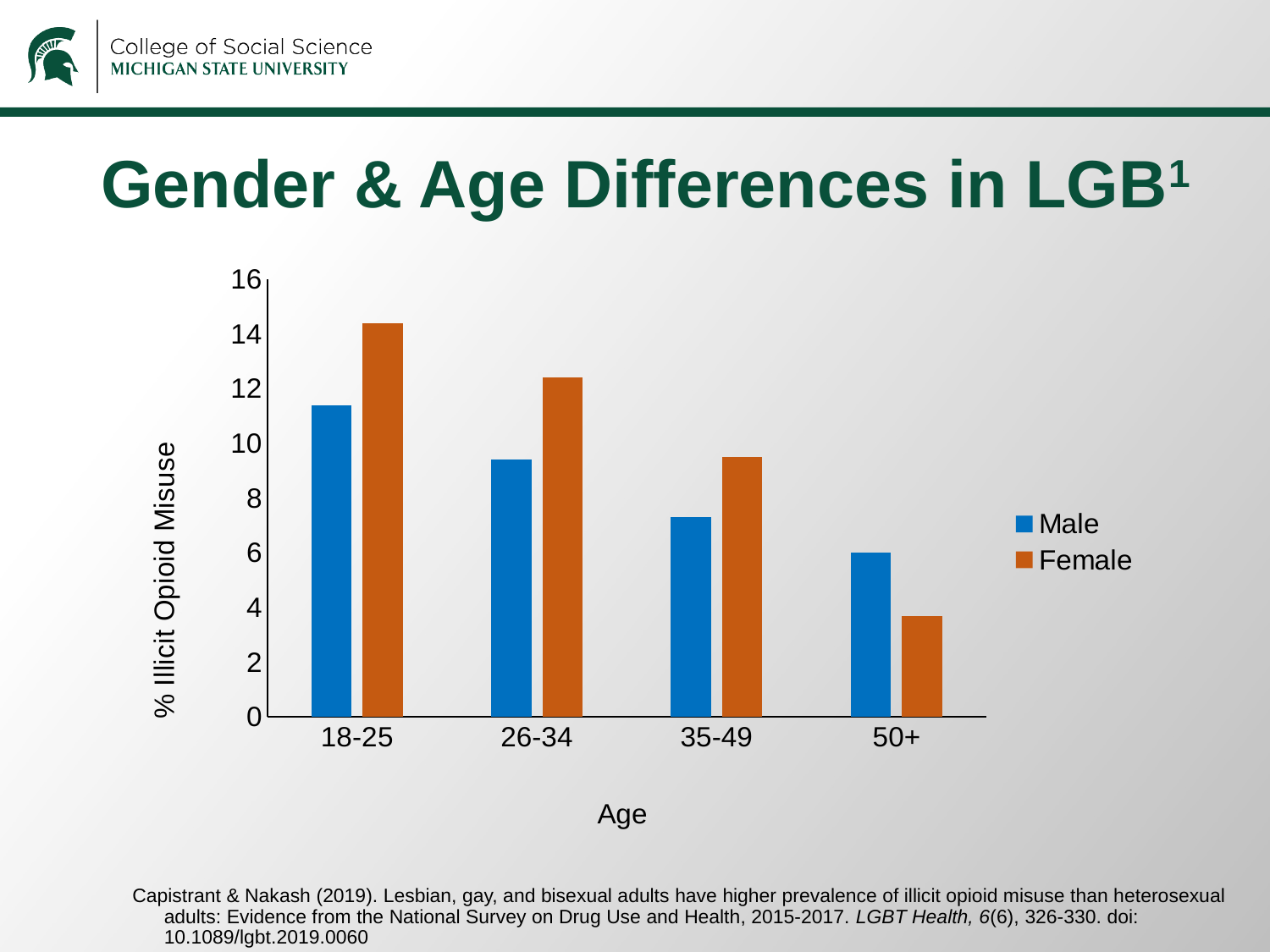
Is the Female value for 50+ greater or less than 4? less For the 50+ age group, which is larger, the Male or the Female value? Male What kind of chart is shown on the slide? bar chart How many age groups are shown on the x axis? 4 Do the Male values rise or fall as age increases along the x axis? fall Which age group has the lowest Male value? 50+ Which age group has the lowest Female value? 50+ Is the Male value for 35-49 greater or less than 8? less What is the label of the y axis? % Illicit Opioid Misuse Is the Female value for 18-25 greater or less than 14? greater Which age group has the highest Female value? 18-25 How many series does the legend list? 2